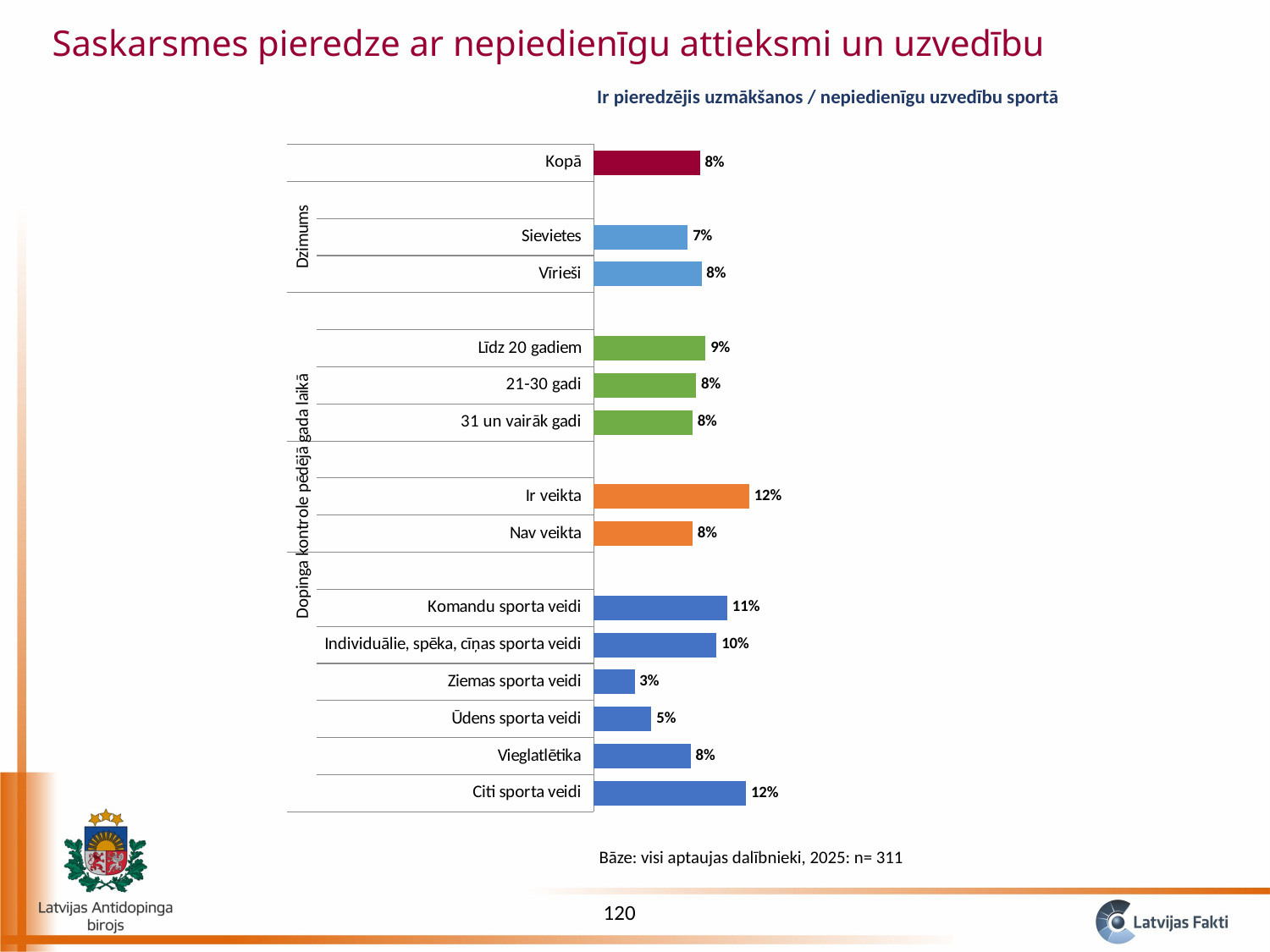
What is the value for Sievietes? 7% How many bars are plotted in the chart? 14 What is the difference between the values for Komandu sporta veidi and Ūdens sporta veidi? 6% Which is larger, the value for Līdz 20 gadiem or the value for 21-30 gadi? Līdz 20 gadiem What is the value for Ir veikta? 12% What is the value for Ziemas sporta veidi? 3% What is the value for Individuālie, spēka, cīņas sporta veidi? 10% What kind of chart is shown on the slide? bar chart Which category has the lowest value? Ziemas sporta veidi Which is larger, the value for Vieglatlētika or the value for Citi sporta veidi? Citi sporta veidi What is the difference between the values for Ir veikta and Nav veikta? 4% What is the value for Kopā? 8%